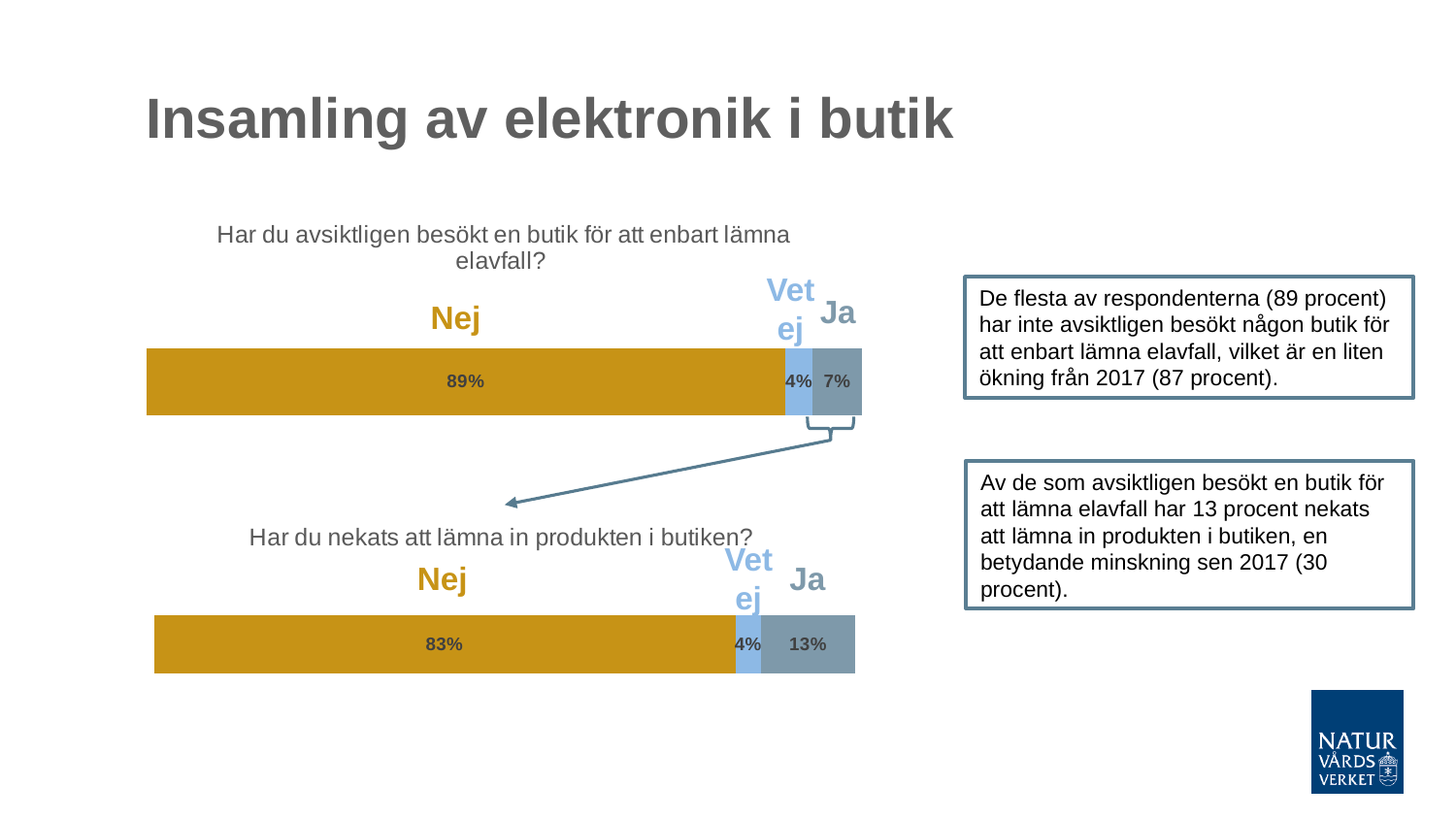
In the chart titled "Har du nekats att lämna in produkten i butiken?", what is the value for Nej? 83% In the chart titled "Har du nekats att lämna in produkten i butiken?", what is the difference between Nej and Ja? 70% In the chart titled "Har du avsiktligen besökt en butik för att enbart lämna elavfall?", what is the value for Ja? 7% In the chart titled "Har du avsiktligen besökt en butik för att enbart lämna elavfall?", what is the value for Nej? 89% In the chart titled "Har du avsiktligen besökt en butik för att enbart lämna elavfall?", which is larger, Ja or Vet ej? Ja What kind of chart is the top chart on the slide? Bar chart In the chart titled "Har du avsiktligen besökt en butik för att enbart lämna elavfall?", what is the value for Vet ej? 4% In the chart titled "Har du avsiktligen besökt en butik för att enbart lämna elavfall?", what is the total of the three segments? 100% In the chart titled "Har du nekats att lämna in produkten i butiken?", what is the value for Ja? 13% In the chart titled "Har du nekats att lämna in produkten i butiken?", how many segments does the bar have? 3 In the chart titled "Har du nekats att lämna in produkten i butiken?", which segment has the smallest value? Vet ej In the chart titled "Har du avsiktligen besökt en butik för att enbart lämna elavfall?", which segment has the largest value? Nej